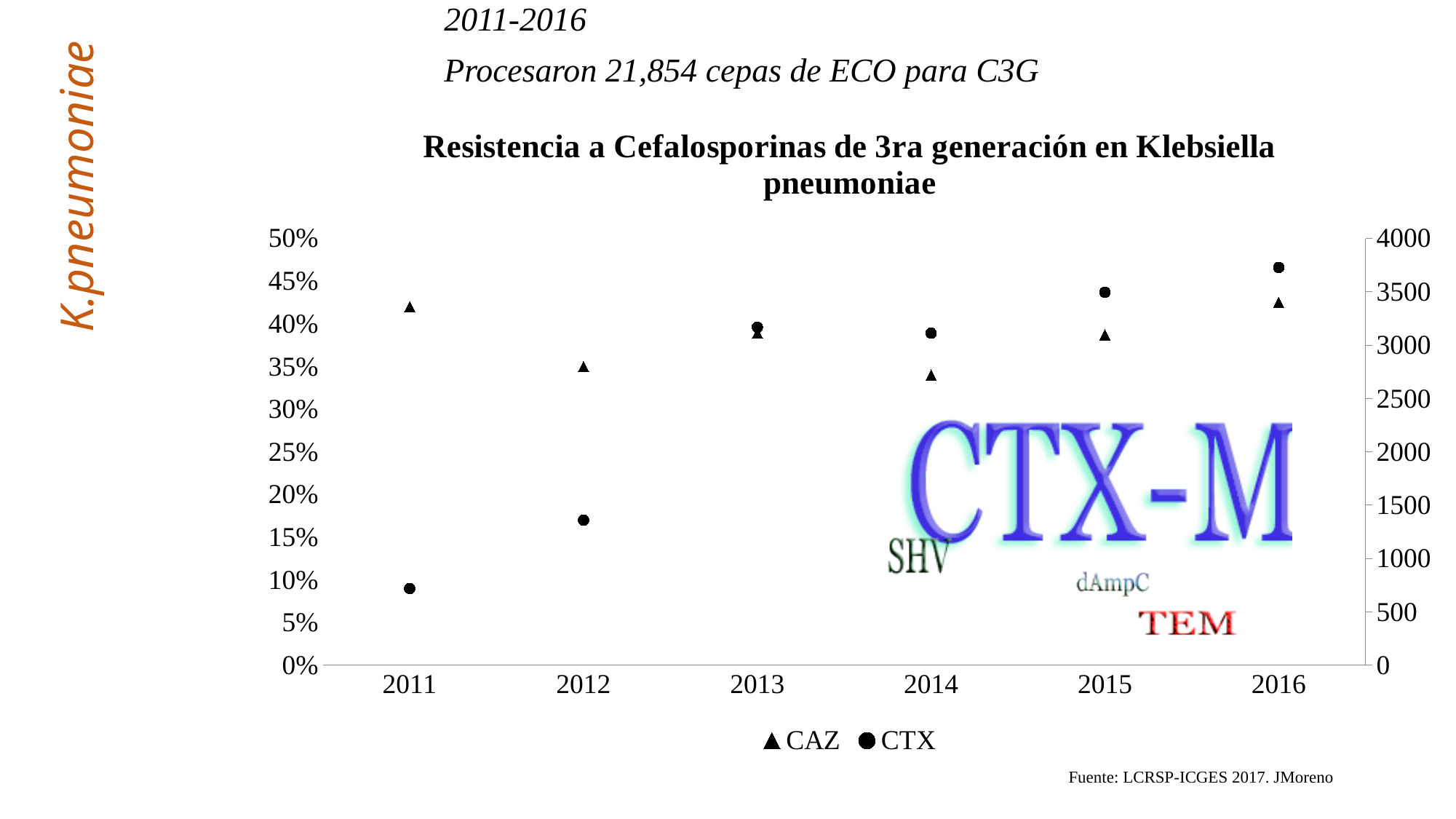
For the CTX series, which year has the larger value, 2011 or 2016? 2016 How many years are shown on the x axis? 6 What kind of chart is shown on the slide? scatter chart What is the title of the chart? Resistencia a Cefalosporinas de 3ra generación en Klebsiella pneumoniae What is the first year shown on the x axis? 2011 Which series is plotted with triangle markers? CAZ In which year is the CTX series at its highest? 2016 In which year is the CTX series at its lowest? 2011 Does the CTX series rise or fall from 2011 to 2016? rise How many series does the legend list? 2 For the CTX series, which year has the larger value, 2012 or 2015? 2015 For the CAZ series, which year has the larger value, 2011 or 2014? 2011